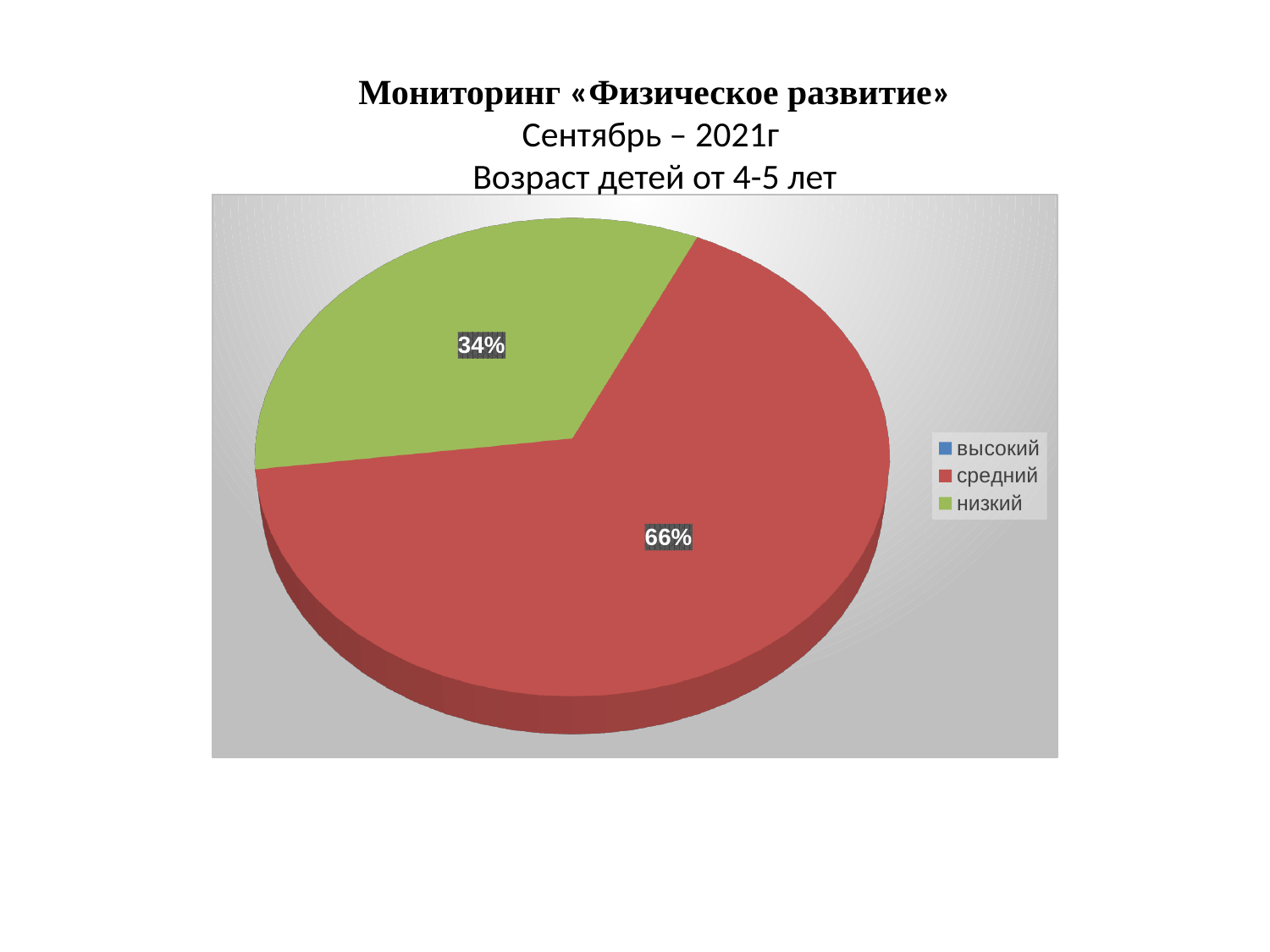
Which category has the largest slice of the pie? средний What share of the pie does the "низкий" slice have? 34% Which of the two visible slices is larger, "средний" or "низкий"? средний Is the share for "средний" greater or less than 50%? greater What is the difference in percentage points between the "средний" and "низкий" slices? 32 What colour is the "средний" slice? red How many entries does the legend list? 3 What colour is the "низкий" slice? green What kind of chart is shown on the slide? pie chart What share of the pie does the "средний" slice have? 66% Which legend entry has no visible slice in the pie? высокий How many slices are visible in the pie? 2